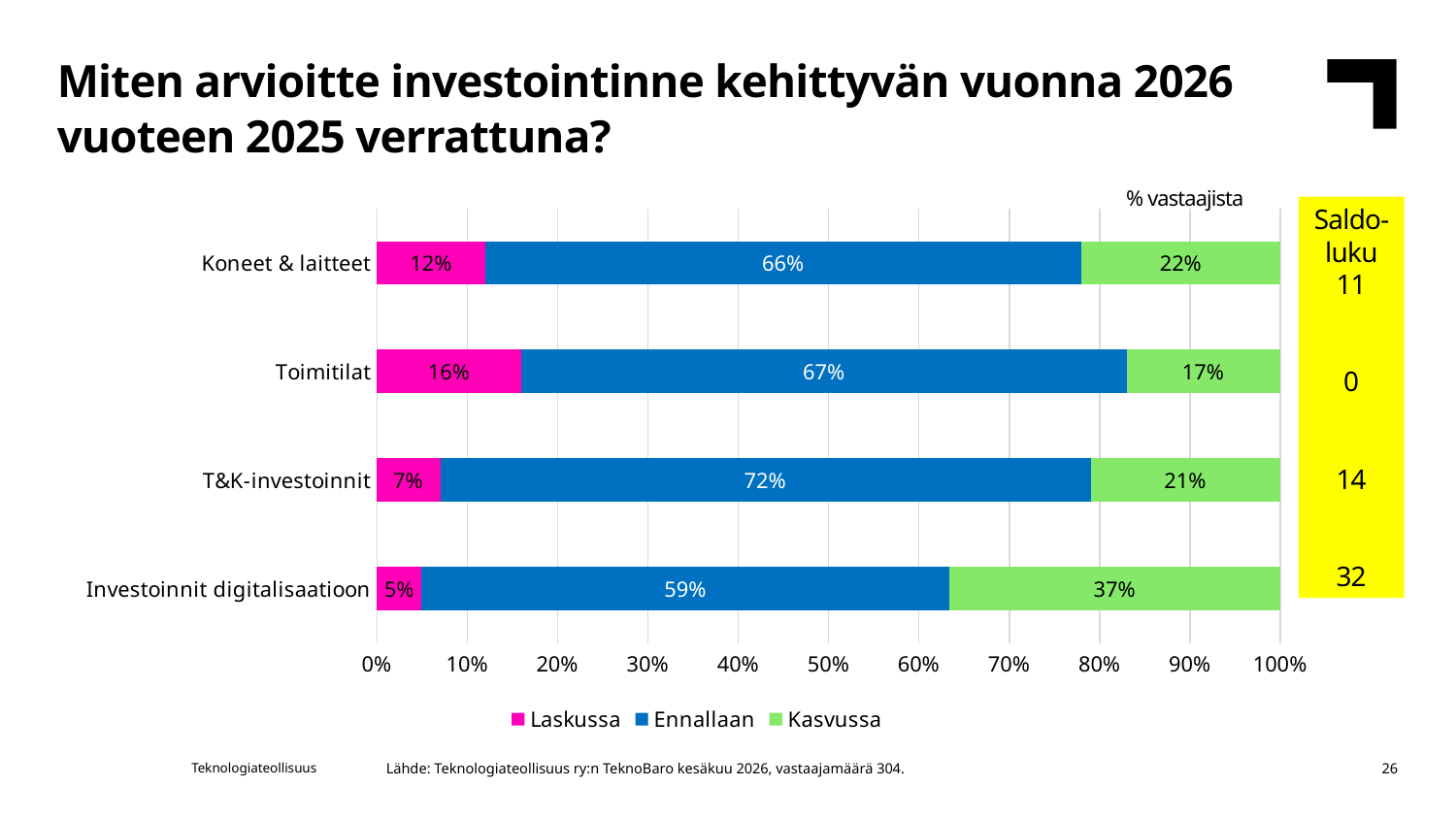
What is the "Laskussa" value for Toimitilat? 16% What percentage of respondents answered "Ennallaan" for Koneet & laitteet? 66% How many categories are shown on the chart? 4 Which category has the lowest "Laskussa" share? Investoinnit digitalisaatioon Which category has the highest "Kasvussa" share? Investoinnit digitalisaatioon Which colour represents the "Laskussa" series in the legend? Magenta (pink) What is the Saldoluku value shown for Investoinnit digitalisaatioon? 32 How many series does the legend list? 3 What is the "Kasvussa" value for Investoinnit digitalisaatioon? 37% What kind of chart is shown on the slide? Stacked bar chart What is the difference between the "Ennallaan" values for T&K-investoinnit and Investoinnit digitalisaatioon? 13 percentage points Which is larger: the "Kasvussa" value for Koneet & laitteet or for Toimitilat? Koneet & laitteet